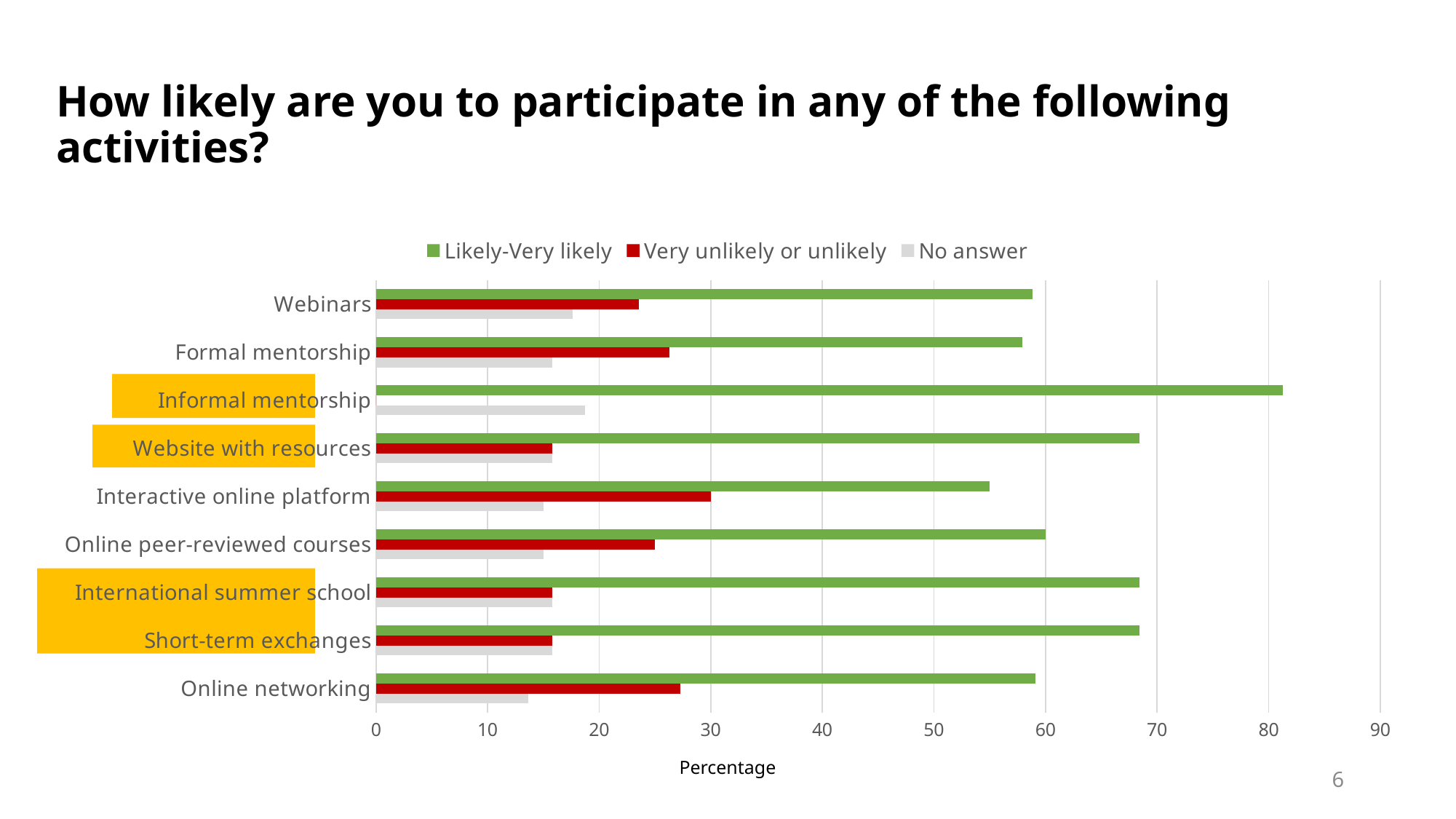
Which activity has the lowest Likely-Very likely value? Interactive online platform Is the Very unlikely or unlikely value for Online networking greater or less than 30? less Which is larger, the Likely-Very likely value for Website with resources or for Webinars? Website with resources What is the label on the horizontal axis of the chart? Percentage What kind of chart is shown on the slide? bar chart Which is larger, the Very unlikely or unlikely value for Interactive online platform or for Webinars? Interactive online platform Which activity has the highest Likely-Very likely value? Informal mentorship Is the Likely-Very likely value for Informal mentorship greater or less than 80? greater How many series does the legend list? 3 Is the Likely-Very likely value for Interactive online platform greater or less than 60? less Which activity has the highest Very unlikely or unlikely value? Interactive online platform How many activities are listed on the chart? 9